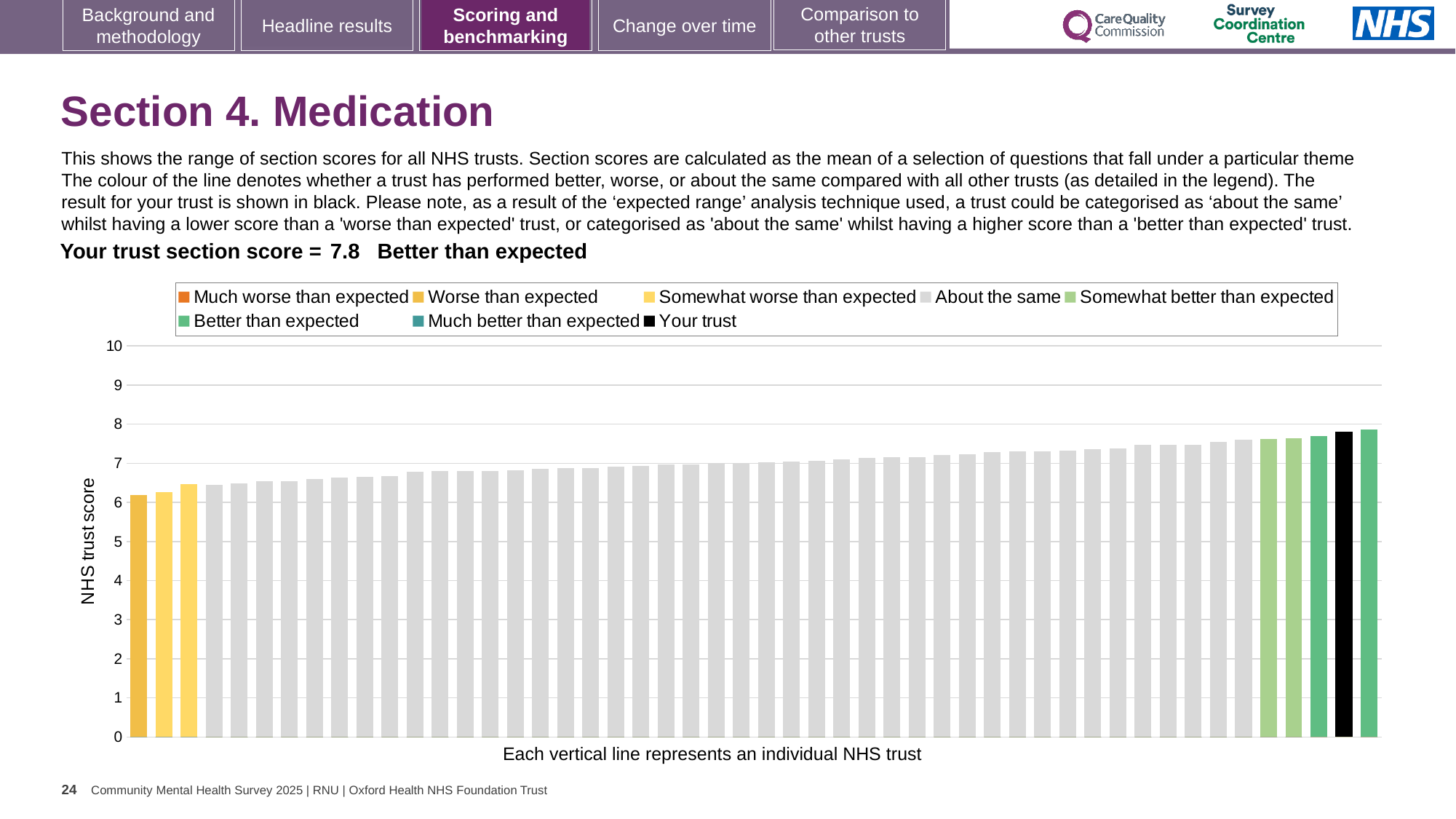
How many entries does the chart legend list? 8 How many bars are coloured yellow (worse or somewhat worse than expected)? 3 Is the value of the leftmost bar greater or less than 6? greater What is the highest value shown on the vertical axis? 10 What is the label on the vertical axis of the chart? NHS trust score Do the bar values rise or fall from left to right across the chart? rise What is the section score for your trust shown on the slide? 7.8 Is the value for your trust greater or less than 7? greater What kind of chart is shown on the slide? bar chart How is your trust's section score categorised compared with other trusts? Better than expected Is the value of the leftmost (lowest) bar greater or less than 7? less What colour is the bar representing your trust? black